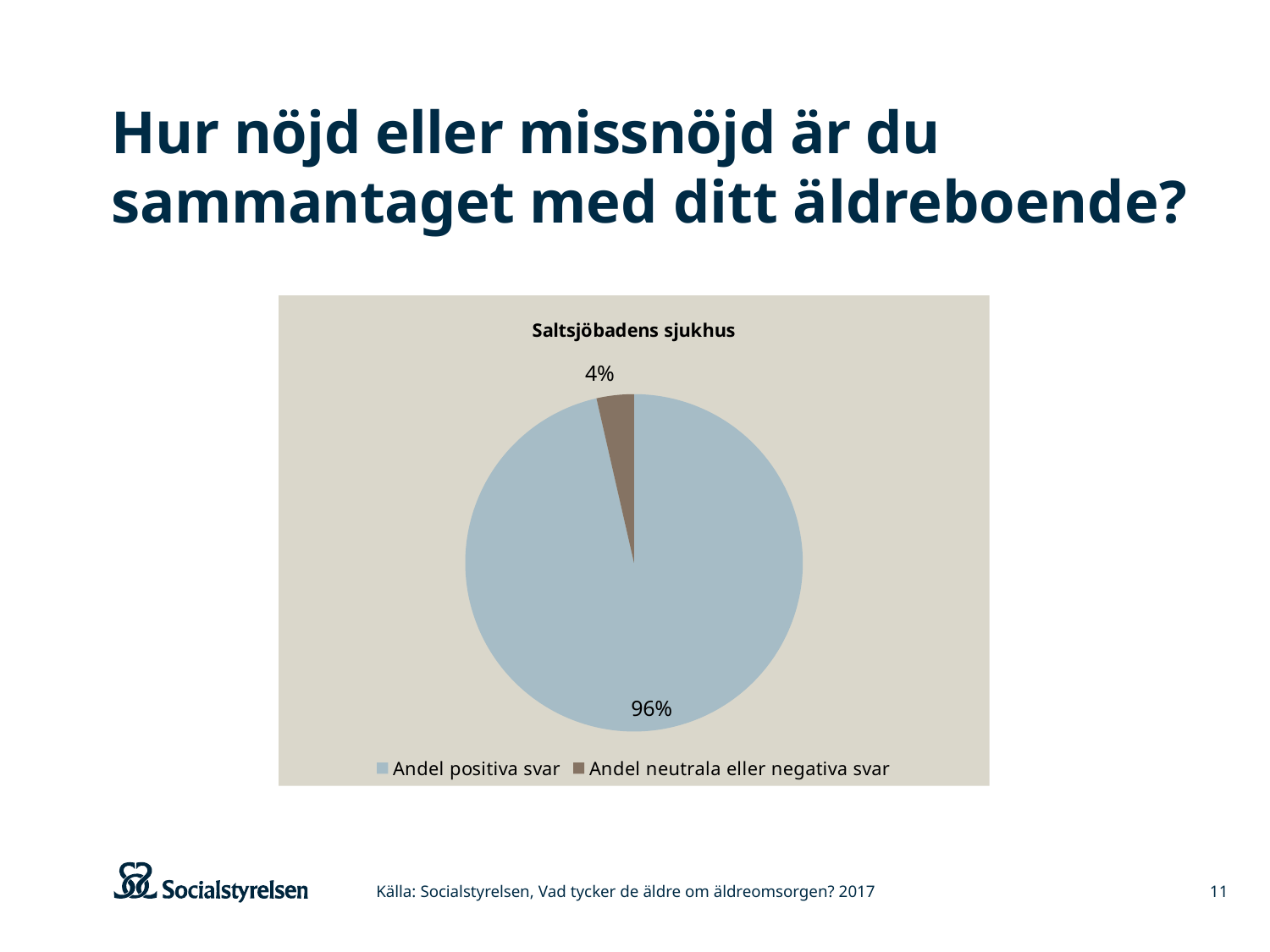
What is the value for "Andel positiva svar"? 96% Which is larger, "Andel positiva svar" or "Andel neutrala eller negativa svar"? Andel positiva svar What is the value for "Andel neutrala eller negativa svar"? 4% Which slice is the smallest? Andel neutrala eller negativa svar Which slice is the largest? Andel positiva svar What colour is the slice for "Andel neutrala eller negativa svar"? brown What is the title of the chart? Saltsjöbadens sjukhus What share of the pie does "Andel positiva svar" represent? 96% What is the difference between "Andel positiva svar" and "Andel neutrala eller negativa svar"? 92% How many entries does the legend list? 2 What kind of chart is shown on the slide? pie chart How many slices does the pie chart have? 2